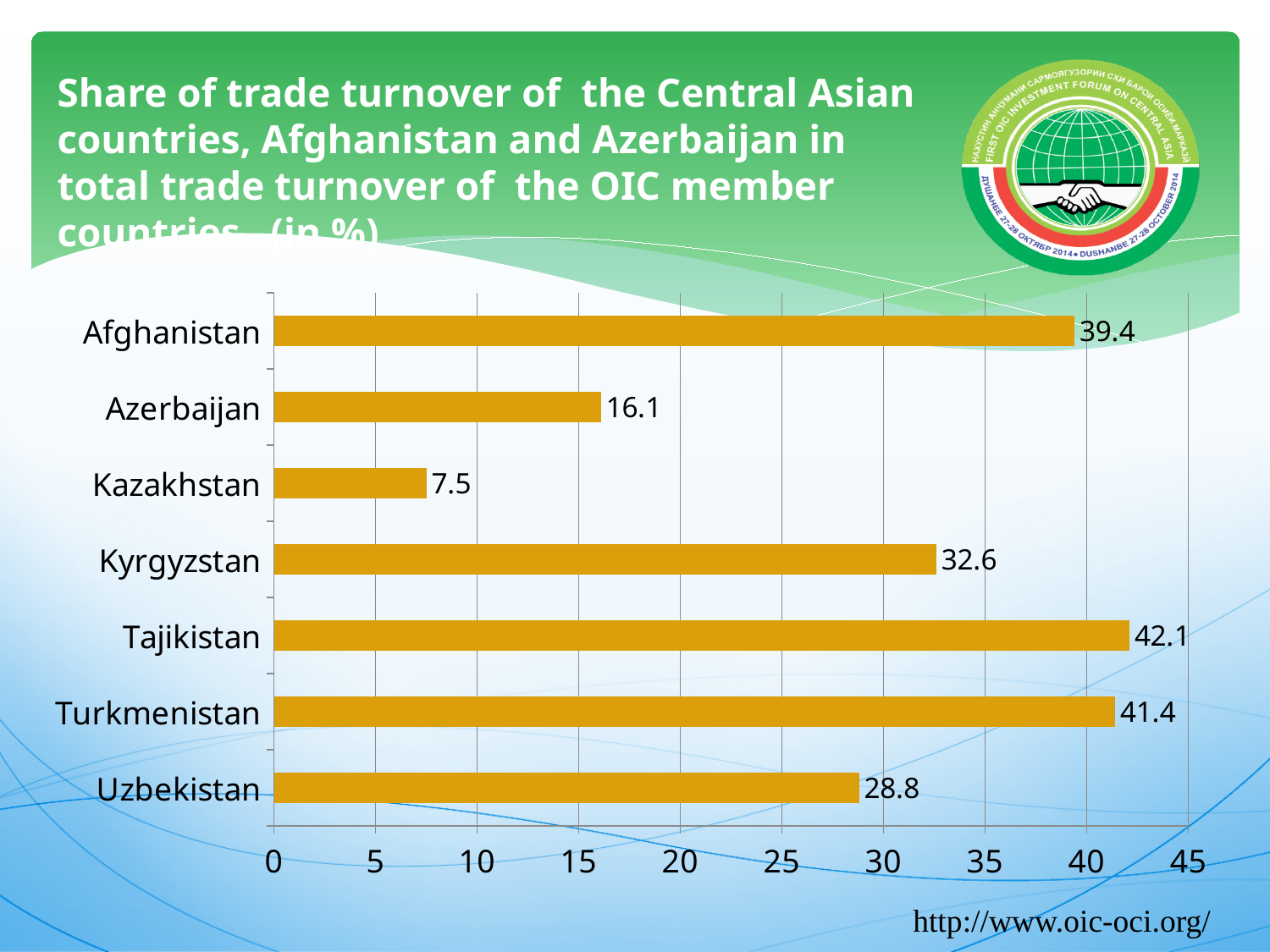
What is the value for Afghanistan? 39.4 Is the value for Azerbaijan greater or less than 20? less What is the value for Kazakhstan? 7.5 What is the difference between the values for Afghanistan and Azerbaijan? 23.3 What is the maximum value shown on the horizontal axis? 45 Which is larger, the value for Kyrgyzstan or the value for Uzbekistan? Kyrgyzstan How many countries are shown in the chart? 7 Which country has the lowest value? Kazakhstan What kind of chart is shown on the slide? bar chart What is the value for Uzbekistan? 28.8 Which country has the highest value? Tajikistan What is the difference between the values for Tajikistan and Turkmenistan? 0.7